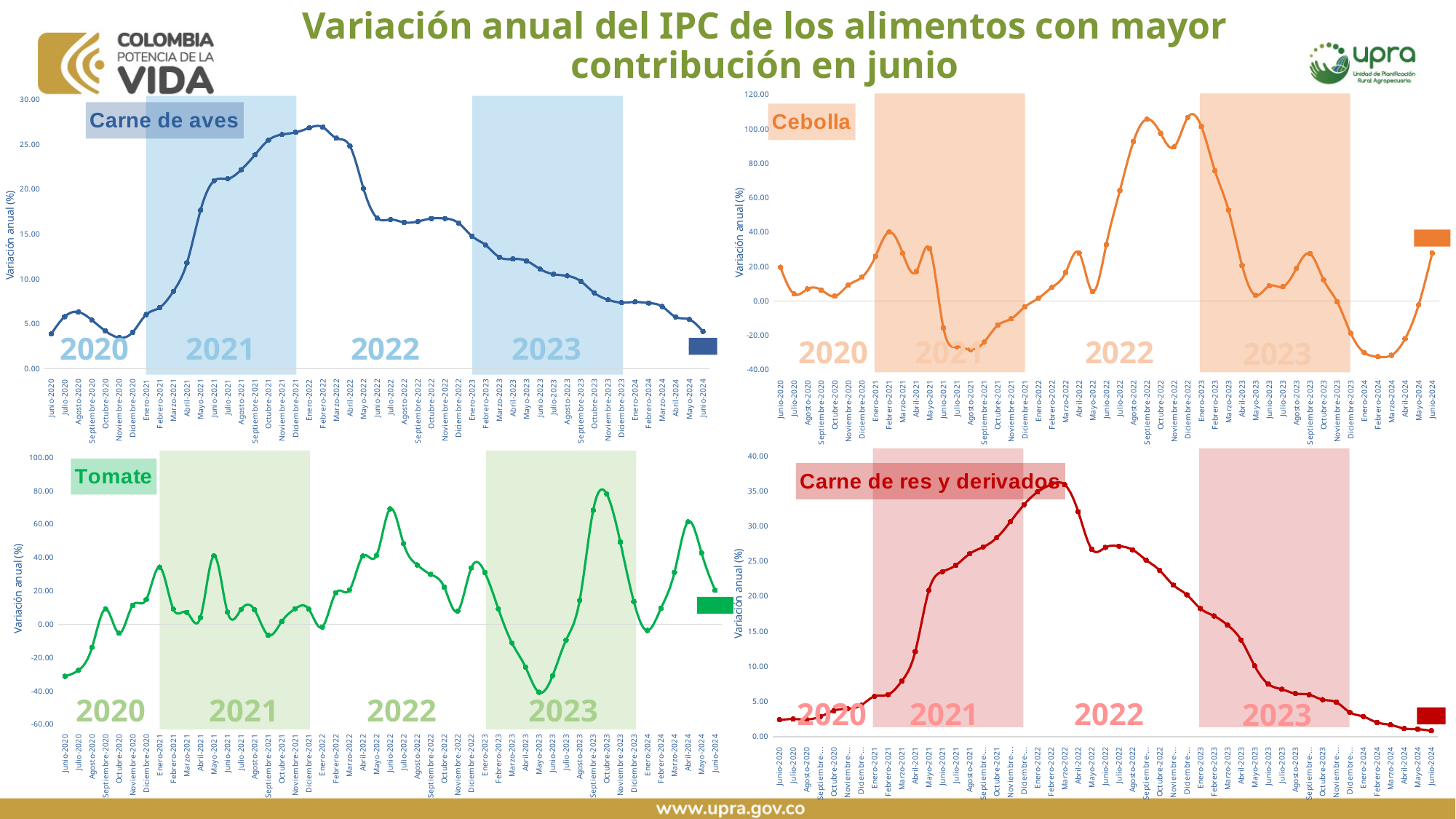
In the Cebolla chart, is the value for Febrero-2024 greater or less than -20.00? less In the Carne de aves chart, which is larger: the value for Febrero-2022 or the value for Junio-2024? Febrero-2022 In the Carne de res y derivados chart, is the value for Marzo-2022 greater or less than 30.00? greater In the Cebolla chart, is the value for Septiembre-2022 greater or less than 100.00? greater What is the label on the vertical axis of the Tomate chart? Variación anual (%) How many charts are shown on the slide? 4 In the Carne de res y derivados chart, do the values rise or fall from Marzo-2022 to Junio-2024? fall What kind of chart is used for the Carne de aves panel? line chart